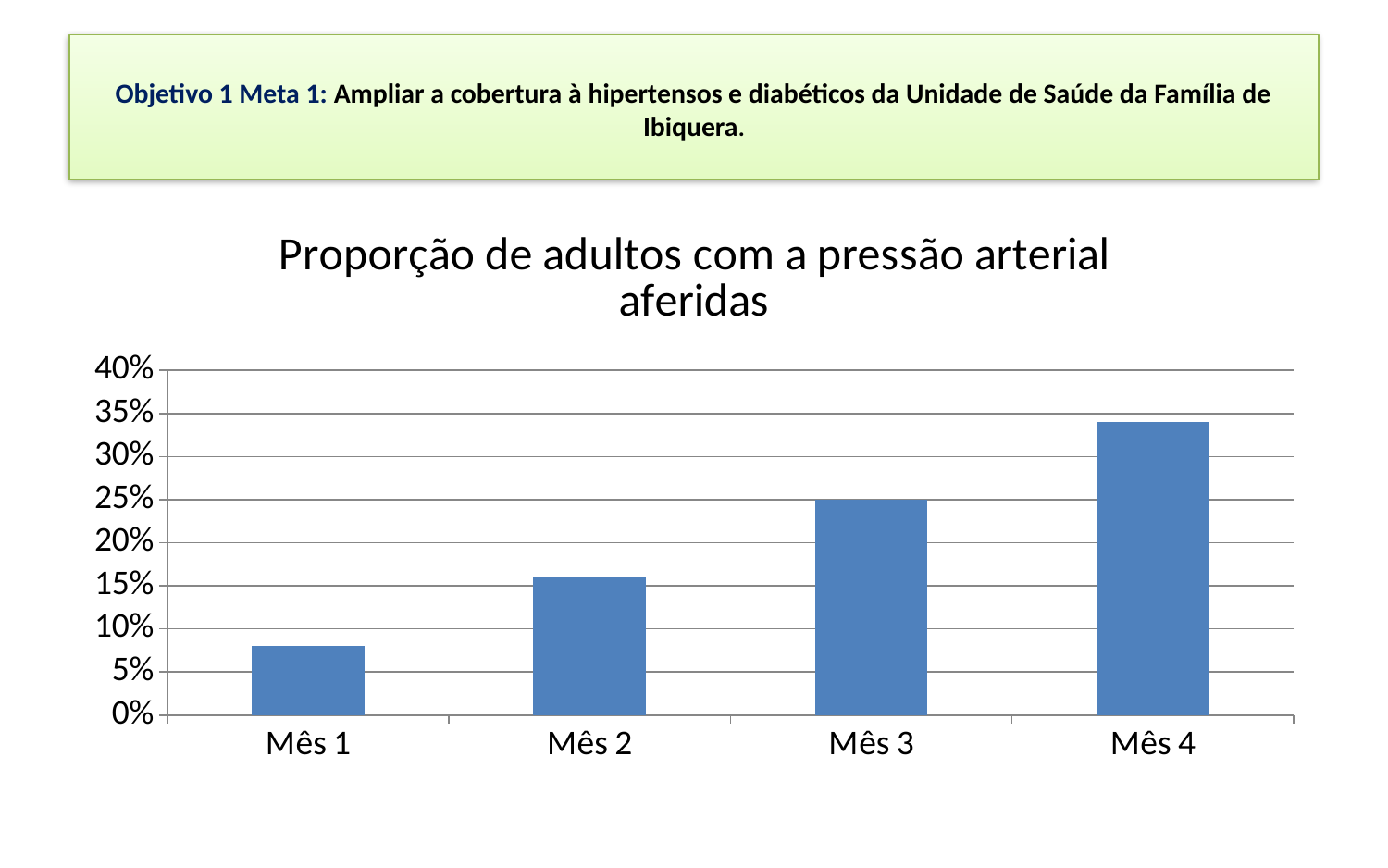
Is the value for Mês 1 greater or less than 10%? less Do the values rise or fall from Mês 1 to Mês 4? rise Which is larger, the value for Mês 2 or the value for Mês 3? Mês 3 Which month has the highest value? Mês 4 What is the value for Mês 3? 25% What kind of chart is shown on the slide? bar chart What is the title of the chart? Proporção de adultos com a pressão arterial aferidas Is the value for Mês 4 greater or less than 30%? greater Which month has the lowest value? Mês 1 How many categories are plotted on the x axis? 4